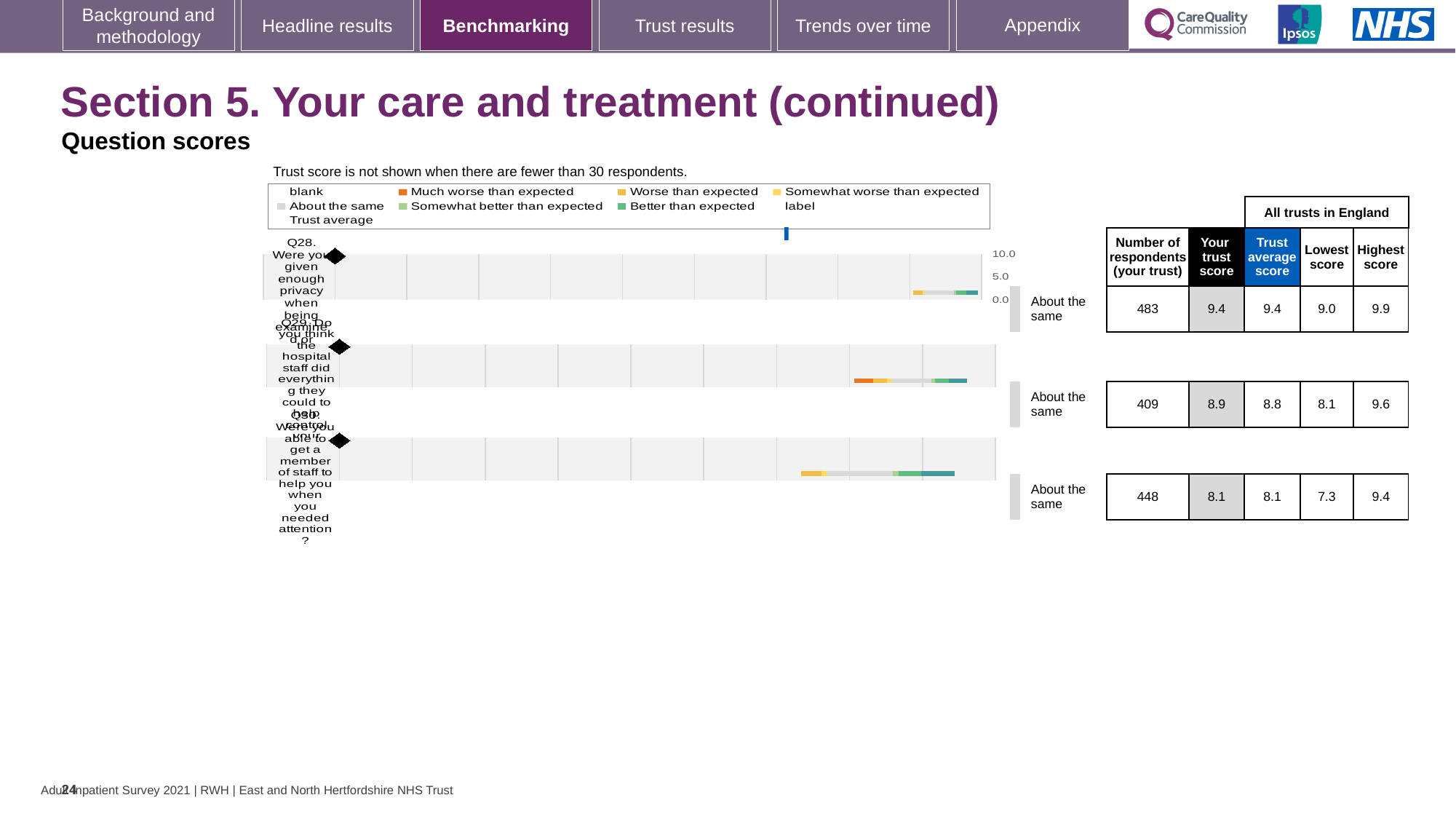
Which question has the lowest trust score? Q30 How many questions (rows) are plotted in the chart? 3 What is the trust score for Q29 (staff did everything to help control pain)? 8.9 Is the trust score for Q29 higher or lower than the trust average score for Q29? higher What is the trust score for Q30 (able to get a member of staff to help when needed)? 8.1 How many respondents answered Q29 at the trust? 409 What kind of chart is shown on the slide? bar chart What is the lowest score across all trusts in England for Q30? 7.3 Which question has the highest trust score? Q28 What benchmark category is shown for Q28? About the same What is the trust score for Q28 (privacy when being examined or treated)? 9.4 What is the difference between the trust scores for Q28 and Q30? 1.3